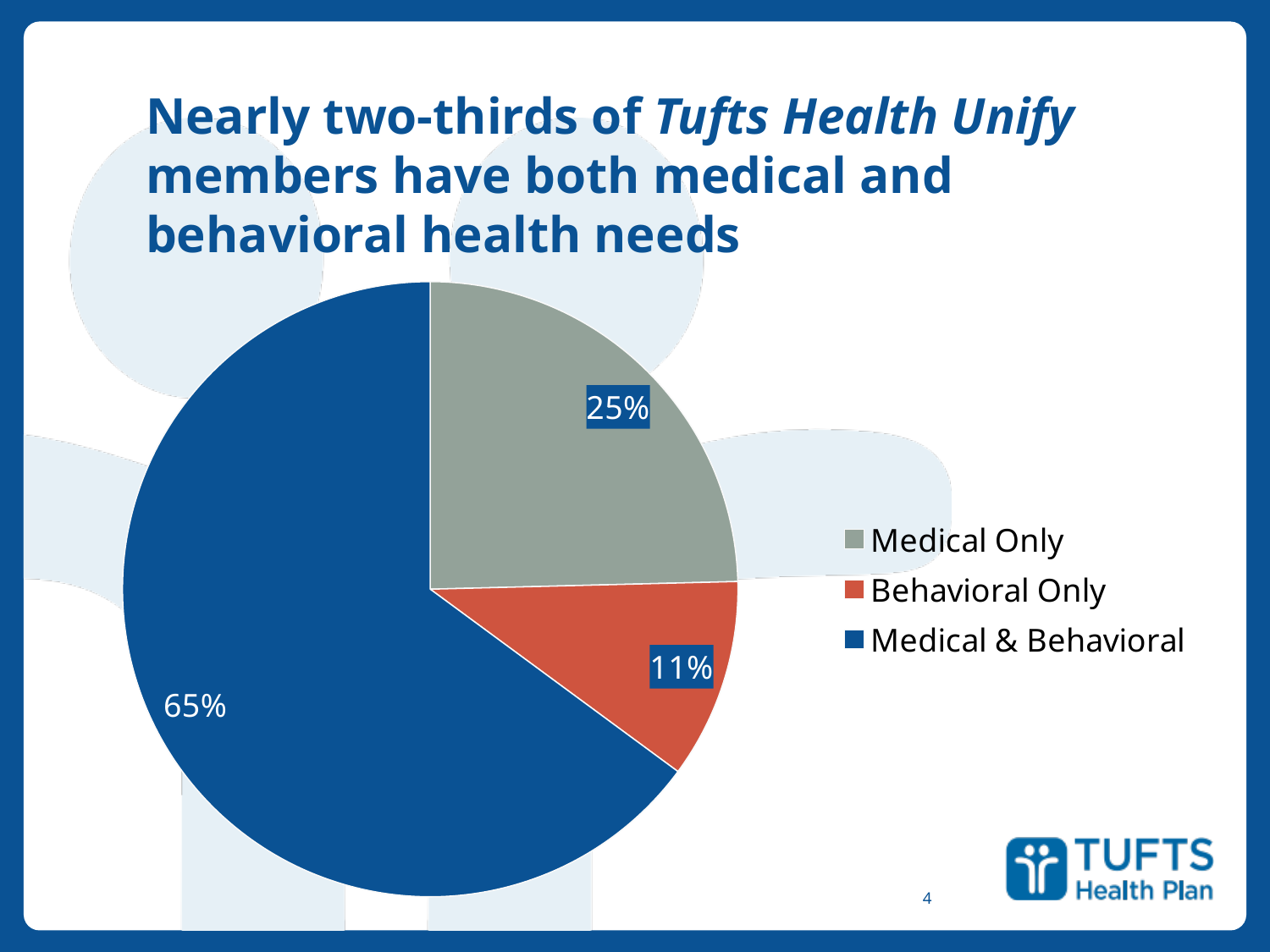
What is the difference in percentage points between Medical Only and Behavioral Only? 14 How many slices does the pie chart have? 3 Which is larger, the Medical Only share or the Behavioral Only share? Medical Only Which category has the smallest share of the pie? Behavioral Only What is the difference in percentage points between Medical & Behavioral and Medical Only? 40 What kind of chart is shown on the slide? Pie chart What share of members have Behavioral Only needs? 11% What share of members have Medical Only needs? 25% What is the combined share of Medical Only and Behavioral Only? 36% What colour is the Behavioral Only slice? Red Which category has the largest share of the pie? Medical & Behavioral What share of members have both Medical & Behavioral needs? 65%